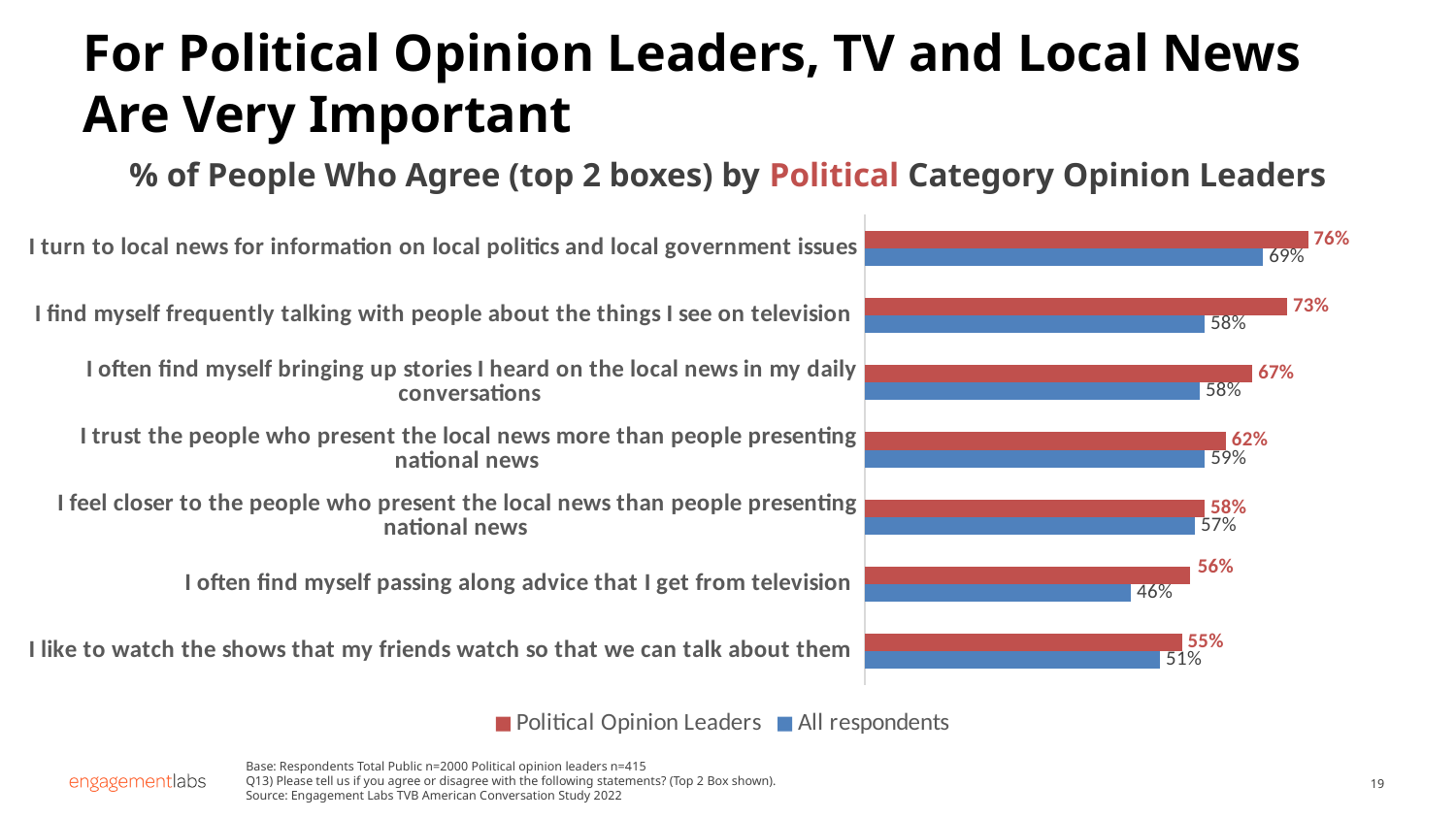
How many statements are shown in the chart? 7 What percentage of All respondents agree with "I like to watch the shows that my friends watch so that we can talk about them"? 51% What percentage of Political Opinion Leaders agree with "I turn to local news for information on local politics and local government issues"? 76% How many series does the legend list? 2 Which statement has the highest agreement among Political Opinion Leaders? I turn to local news for information on local politics and local government issues What kind of chart is shown on the slide? Bar chart What is the difference between Political Opinion Leaders and All respondents for "I find myself frequently talking with people about the things I see on television"? 15 percentage points What percentage of All respondents agree with "I often find myself passing along advice that I get from television"? 46% For "I trust the people who present the local news more than people presenting national news", which group has the higher agreement: Political Opinion Leaders or All respondents? Political Opinion Leaders Which statement has the lowest agreement among All respondents? I often find myself passing along advice that I get from television What is the difference between Political Opinion Leaders and All respondents for "I often find myself passing along advice that I get from television"? 10 percentage points Which colour represents Political Opinion Leaders in the chart? Red